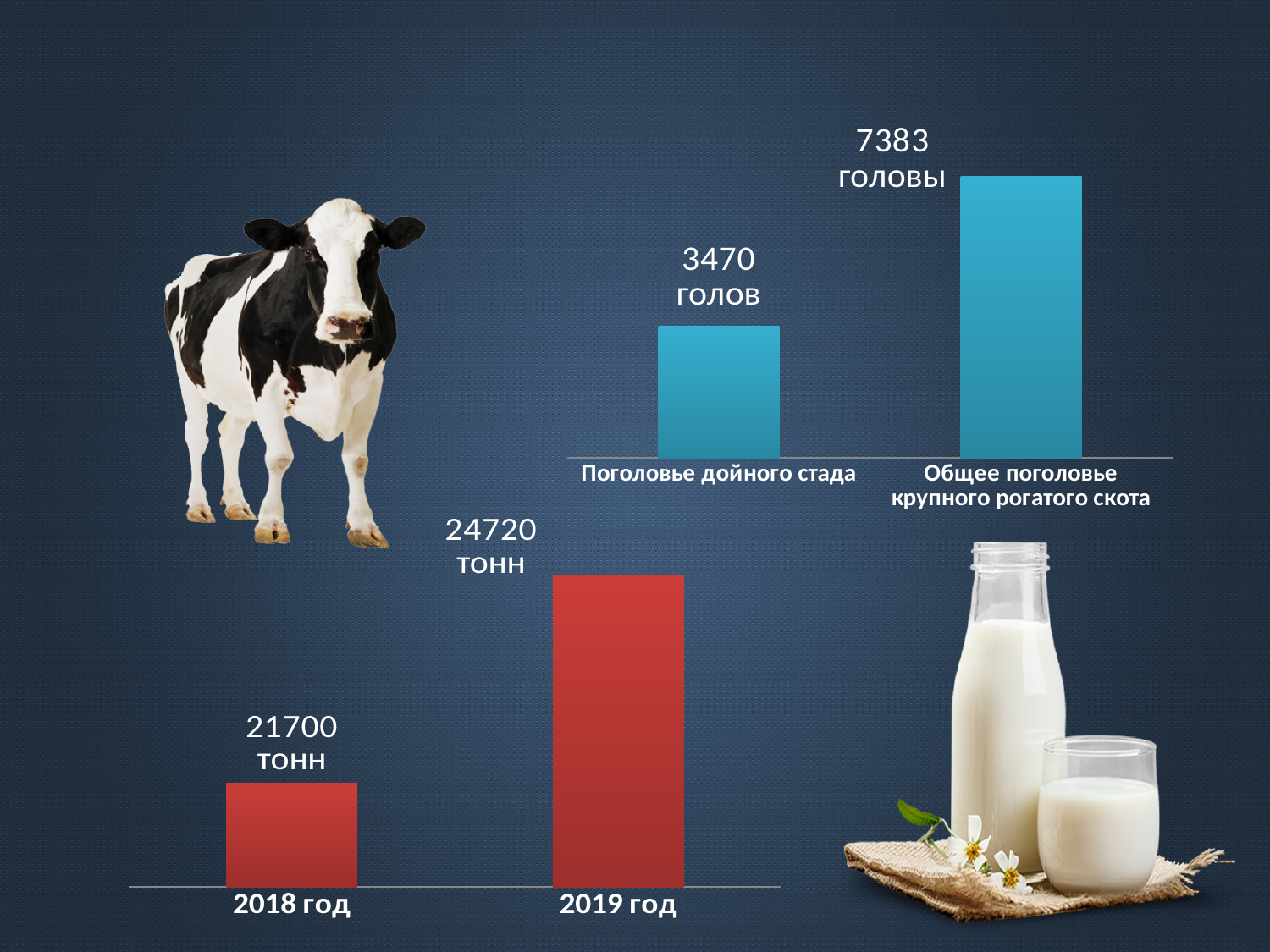
In the top-right chart, what is the value for Поголовье дойного стада? 3470 голов In the top-right chart, which category has the higher value? Общее поголовье крупного рогатого скота What colour are the bars in the bottom-left chart? Red In the bottom-left chart, by how much did the value increase from 2018 год to 2019 год? 3020 тонн In the bottom-left chart, which year has the lower value? 2018 год In the bottom-left chart, what is the value for 2019 год? 24720 тонн In the top-right chart, how many bars are shown? 2 What type of chart is the top-right chart? Bar chart In the bottom-left chart, do the values rise or fall from 2018 год to 2019 год? Rise In the top-right chart, what is the difference between Общее поголовье крупного рогатого скота and Поголовье дойного стада? 3913 In the top-right chart, what is the value for Общее поголовье крупного рогатого скота? 7383 головы In the bottom-left chart, what is the value for 2018 год? 21700 тонн